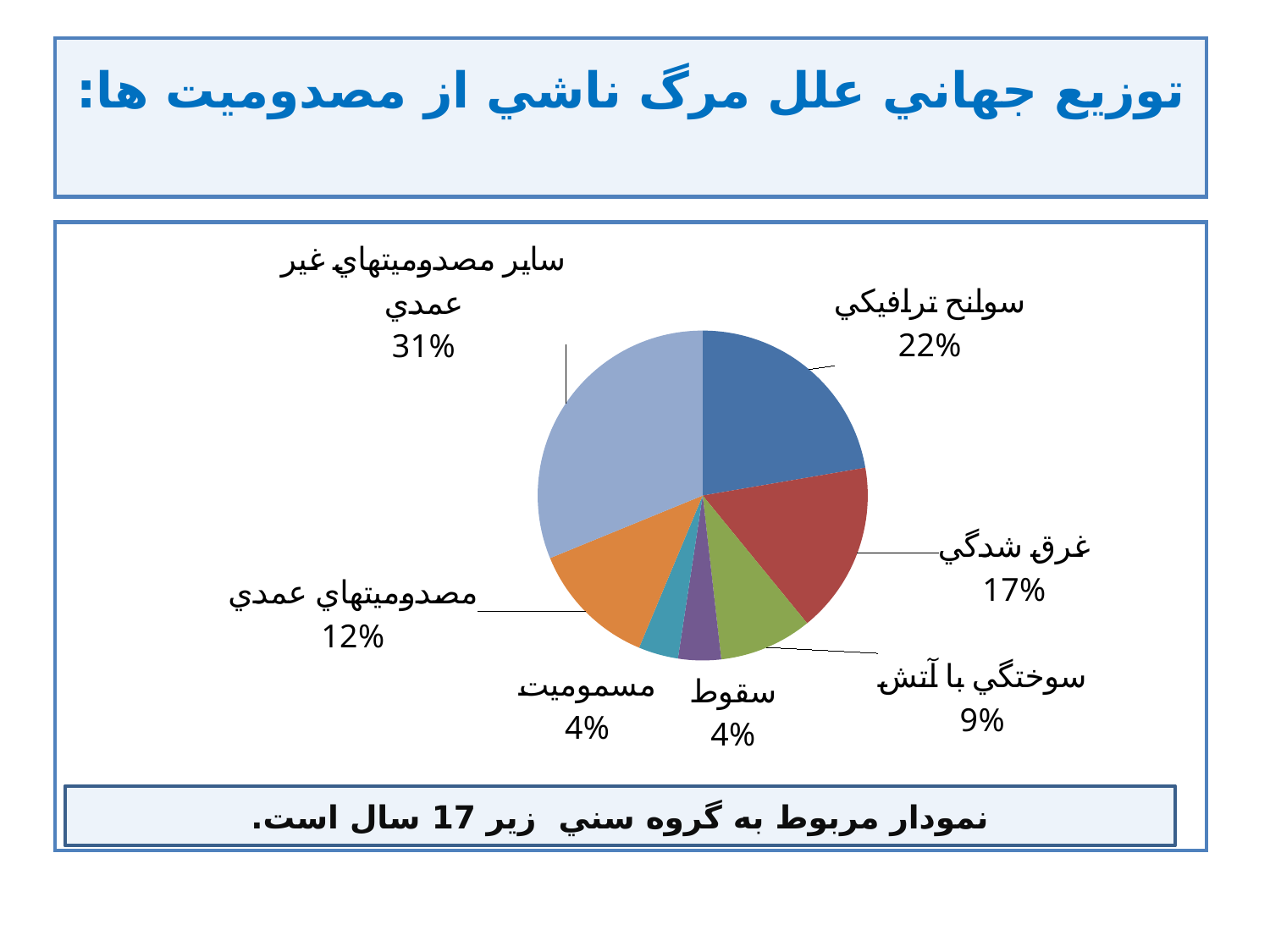
What percentage is shown for غرق شدگي (drowning)? 17% What percentage is shown for سوانح ترافيكي (traffic accidents)? 22% What is the combined share of سقوط and مسموميت? 8% What percentage is shown for مصدوميتهاي عمدي (intentional injuries)? 12% Which is larger, the share for مصدوميتهاي عمدي or the share for سوختگي با آتش? مصدوميتهاي عمدي How many slices does the pie chart have? 7 Which categories share the smallest value in the pie chart? سقوط and مسموميت (4% each) What percentage is shown for سوختگي با آتش (burns from fire)? 9% What is the difference between the shares of سوانح ترافيكي and غرق شدگي? 5% According to the note below the chart, which age group does the chart refer to? under 17 years Which category has the largest share of the pie? ساير مصدوميتهاي غير عمدي (31%) What type of chart is shown on the slide? pie chart